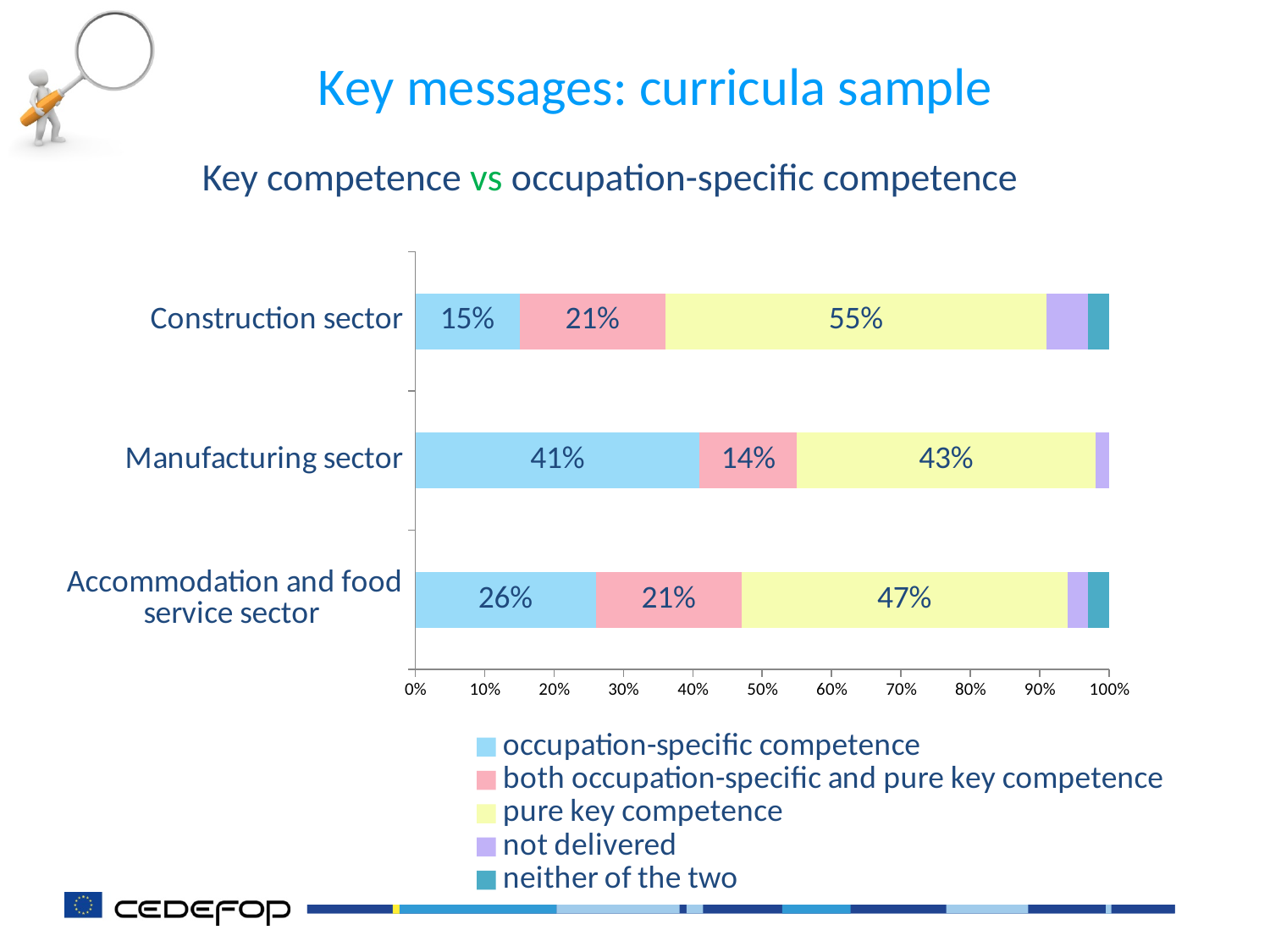
Is the value for pure key competence in the Accommodation and food service sector greater or less than 40%? greater How many sectors are shown on the chart? 3 What is the value for occupation-specific competence in the Manufacturing sector? 41% What is the difference between the pure key competence values for the Construction sector and the Manufacturing sector? 12% What share of the Accommodation and food service sector is both occupation-specific and pure key competence? 21% Which sector has the highest value for occupation-specific competence? Manufacturing sector What percentage of the Construction sector bar is pure key competence? 55% How many series does the legend list? 5 Which sector has the lowest value for pure key competence? Manufacturing sector Which legend entry is shown in yellow? pure key competence Which is larger: occupation-specific competence in the Construction sector or in the Accommodation and food service sector? Accommodation and food service sector What kind of chart is shown on the slide? Stacked bar chart